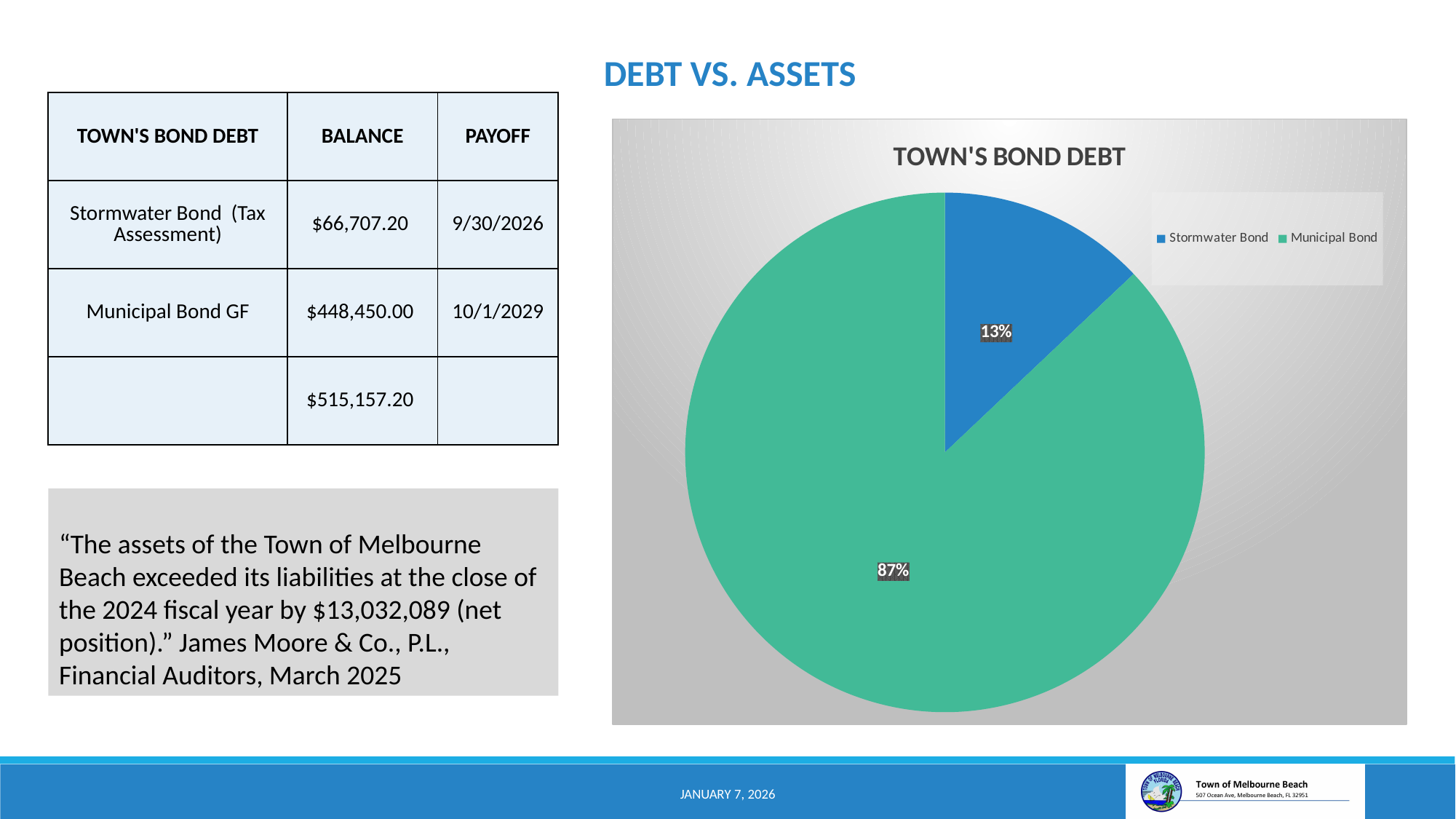
What colour is the Municipal Bond slice? Green Which slice of the pie is the largest? Municipal Bond What share of the pie does the Municipal Bond slice represent? 87% What share of the pie does the Stormwater Bond slice represent? 13% What type of chart is shown on the slide? Pie chart How many entries does the legend list? 2 How many slices does the pie chart have? 2 Which is larger, the Stormwater Bond slice or the Municipal Bond slice? Municipal Bond Which slice of the pie is the smallest? Stormwater Bond What is the difference in percentage points between the Municipal Bond share and the Stormwater Bond share? 74 percentage points What is the title of the chart? TOWN'S BOND DEBT